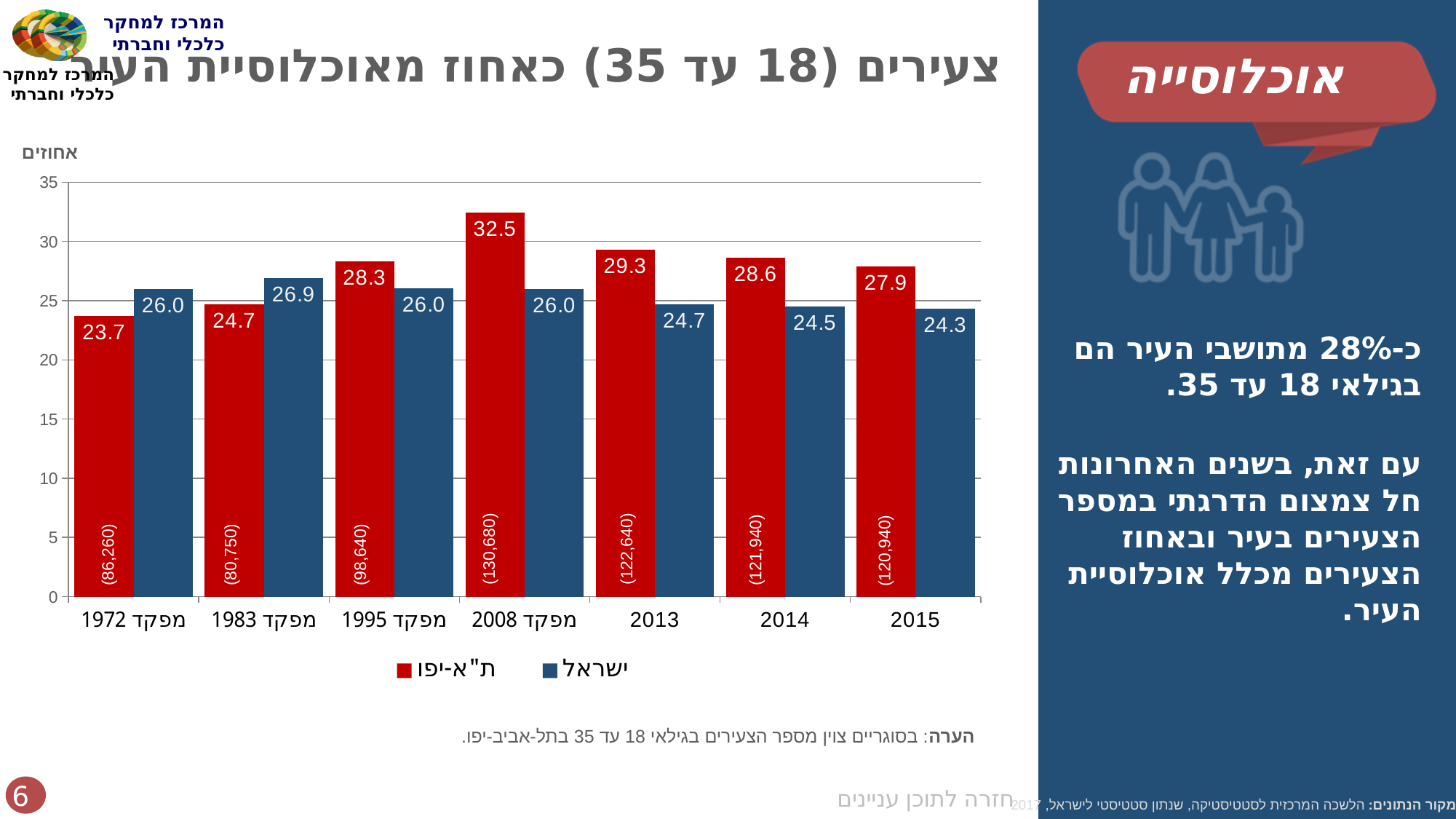
In which category is the ת"א-יפו value highest? מפקד 2008 What is the difference between the ת"א-יפו and ישראל values in מפקד 2008? 6.5 What is the value for ת"א-יפו in מפקד 1972? 23.7 What number is printed in parentheses inside the ת"א-יפו bar for 2014? (121,940) Which is larger in מפקד 1983: the ת"א-יפו value or the ישראל value? ישראל In which category is the ישראל value lowest? 2015 What is the value for ת"א-יפו in מפקד 2008? 32.5 What kind of chart is shown on the slide? bar chart What is the value for ישראל in 2015? 24.3 How many categories are shown on the x axis? 7 How many series does the legend list? 2 Is the ת"א-יפו value for 2013 greater or less than 25? greater